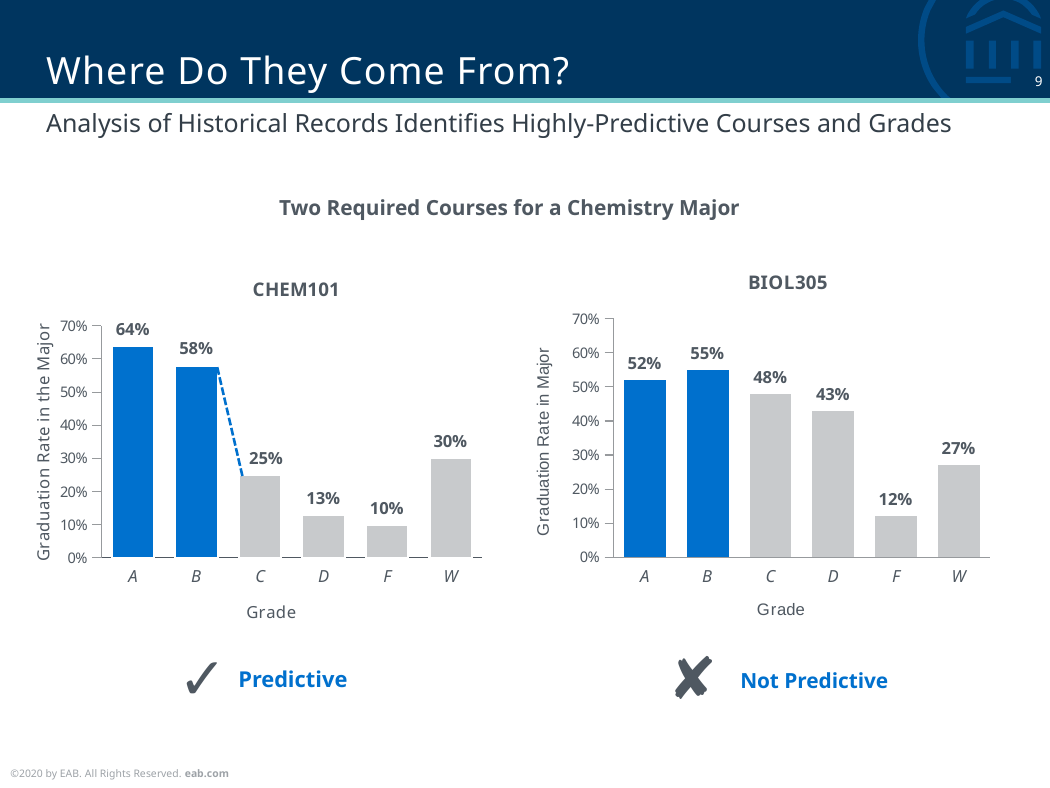
What is the title of the chart on the right side of the slide? BIOL305 How many grade categories are shown in the CHEM101 chart? 6 In the BIOL305 chart, is the graduation rate for grade D greater or less than 40%? greater What type of chart is the BIOL305 chart? Bar chart In the CHEM101 chart, which is larger, the graduation rate for grade W or grade C? W In the BIOL305 chart, which grade has the highest graduation rate? B In the CHEM101 chart, what is the difference between the graduation rates for grade B and grade C? 33% In the CHEM101 chart, what is the graduation rate for grade A? 64% In the BIOL305 chart, what is the difference between the graduation rates for grade A and grade W? 25% In the BIOL305 chart, what is the graduation rate for grade F? 12% In the CHEM101 chart, which grade has the lowest graduation rate? F In the CHEM101 chart, what is the graduation rate for grade W? 30%